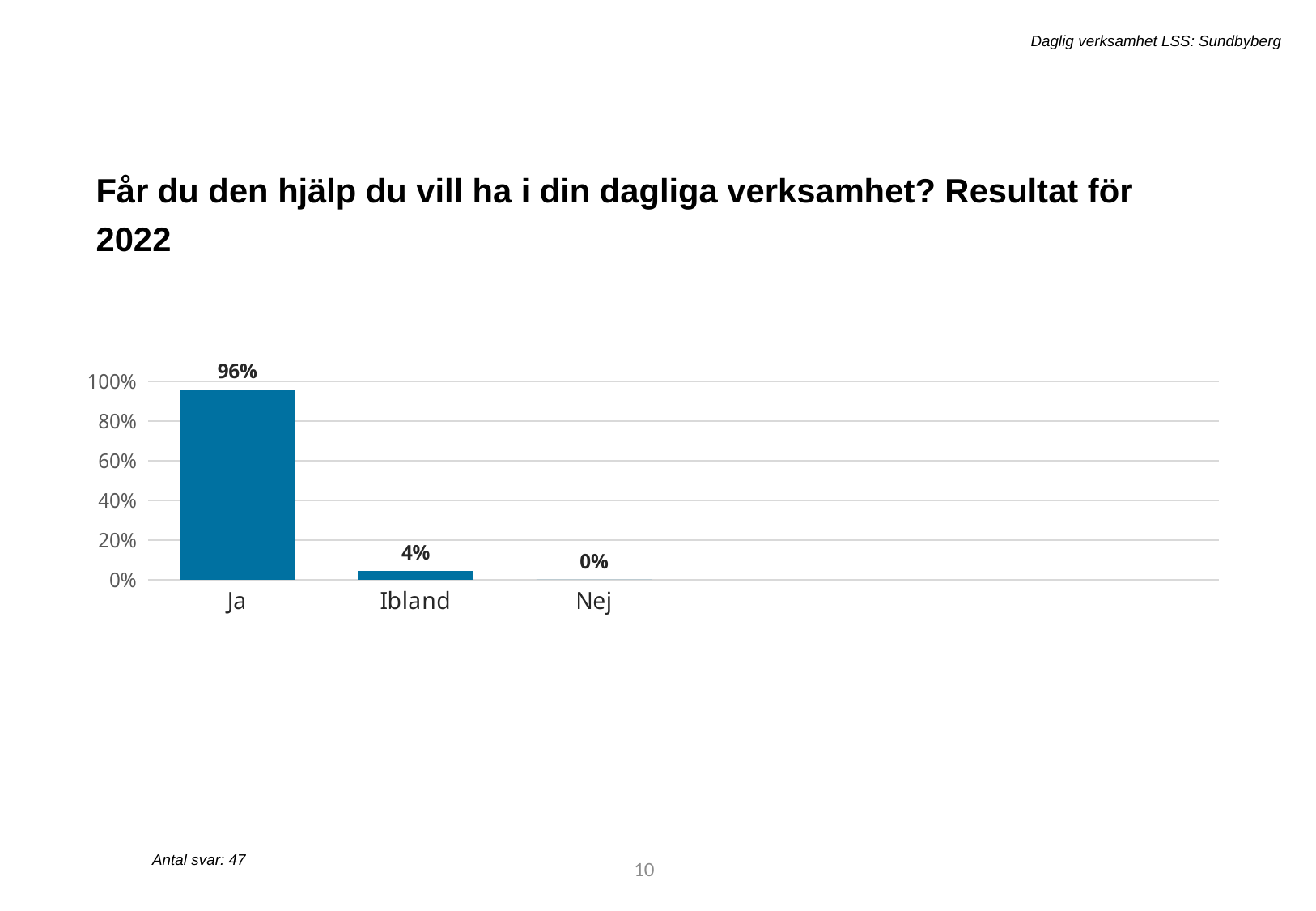
Which category has the highest value? Ja What is the value for Nej? 0% Is the value for Ja greater or less than 80%? greater Which is larger, the value for Ibland or the value for Nej? Ibland How many responses (Antal svar) does the slide report? 47 What is the value for Ja? 96% What kind of chart is shown on the slide? bar chart How many categories are shown on the x axis? 3 What is the value for Ibland? 4% What is the difference between the values for Ja and Ibland? 92% Which category has the lowest value? Nej Is the value for Ibland greater or less than 20%? less